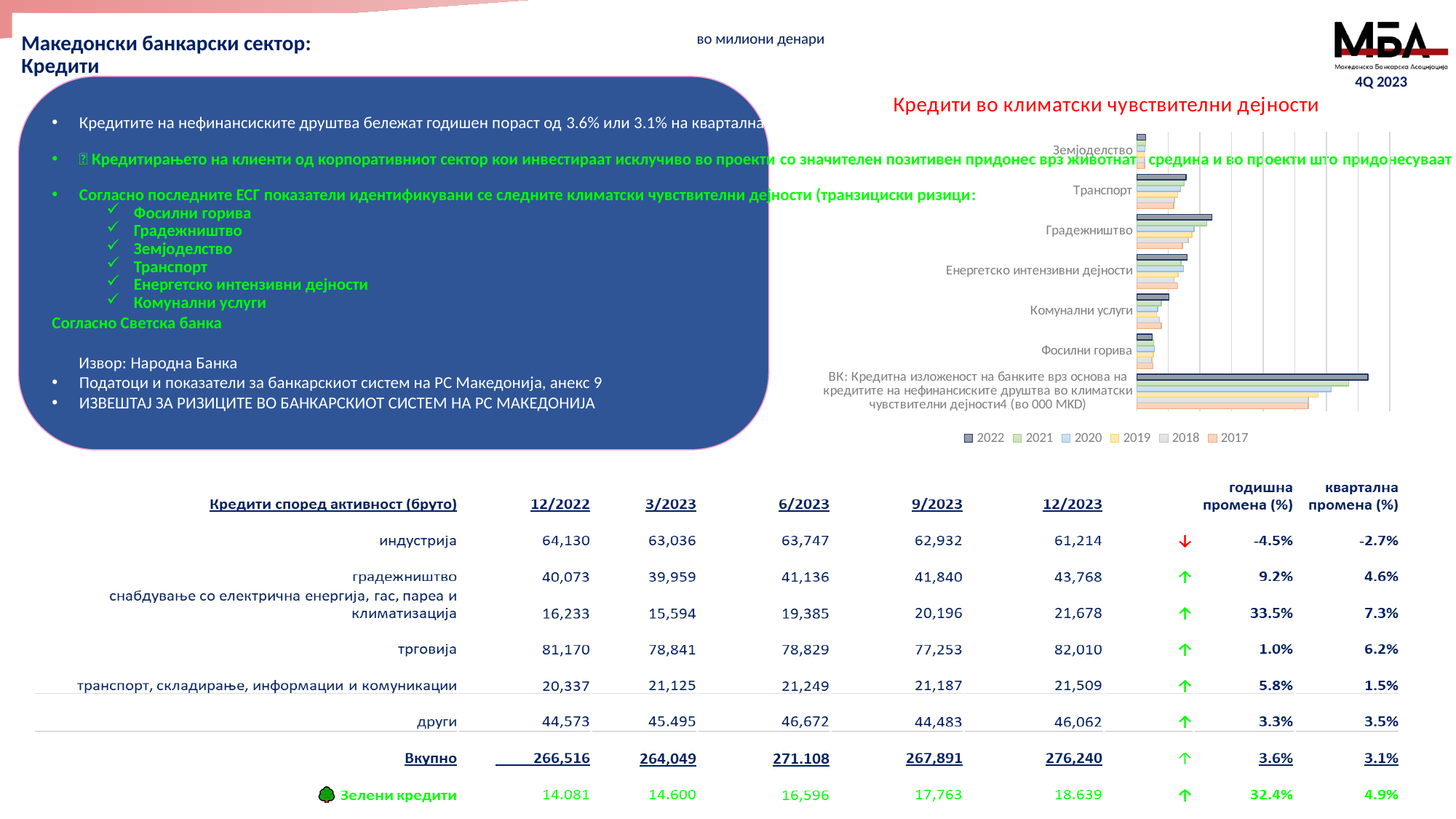
How many series does the chart's legend list? 6 Which category has the shortest bars on the chart? Земјоделство For the 2022 series, which is larger: Транспорт or Фосилни горива? Транспорт Which category has the longest bars on the chart? ВК: Кредитна изложеност на банките врз основа на кредитите на нефинансиските друштва во климатски чувствителни дејности4 (во 000 MKD) How many categories are plotted on the chart? 7 Which year is the first entry in the chart's legend? 2022 For the 2022 series, which is larger: Градежништво or Комунални услуги? Градежништво What kind of chart is shown on the slide? bar chart Among the six sector categories (excluding the total ВК row), which has the longest 2022 bar? Градежништво What is the title of the chart on the slide? Кредити во климатски чувствителни дејности